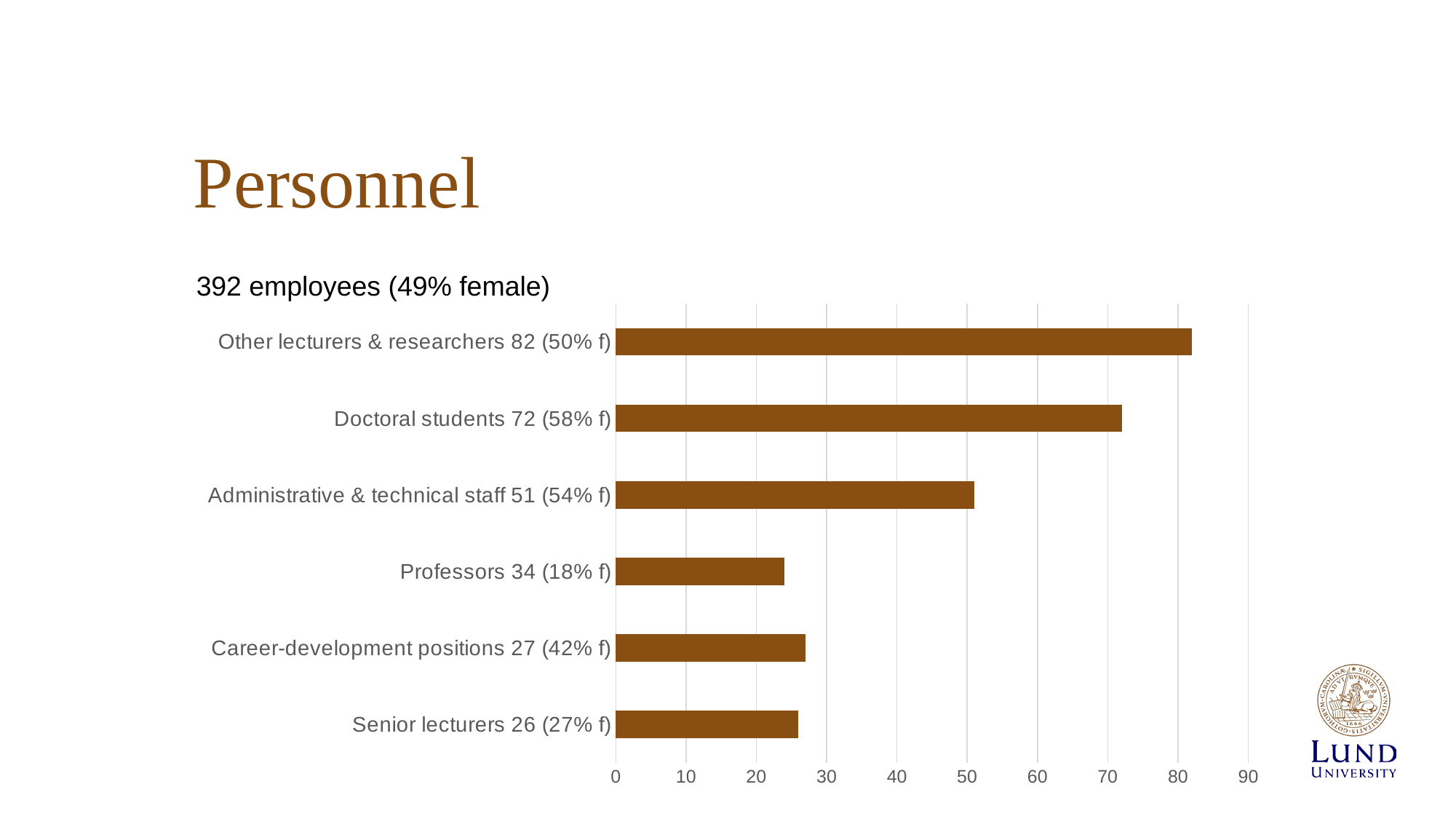
What is the value for Administrative & technical staff? 51 What percentage of Doctoral students are female according to the chart label? 58% Is the value for Career-development positions greater or less than 30? less What kind of chart is shown on the slide? bar chart Which category has the highest value in the chart? Other lecturers & researchers Which is larger, Doctoral students or Administrative & technical staff? Doctoral students How many personnel categories are plotted in the chart? 6 How many Senior lecturers are shown in the chart? 26 How many employees are in the Other lecturers & researchers category? 82 What is the difference between Doctoral students and Administrative & technical staff? 21 How many Doctoral students are shown in the chart? 72 What is the difference between Other lecturers & researchers and Doctoral students? 10